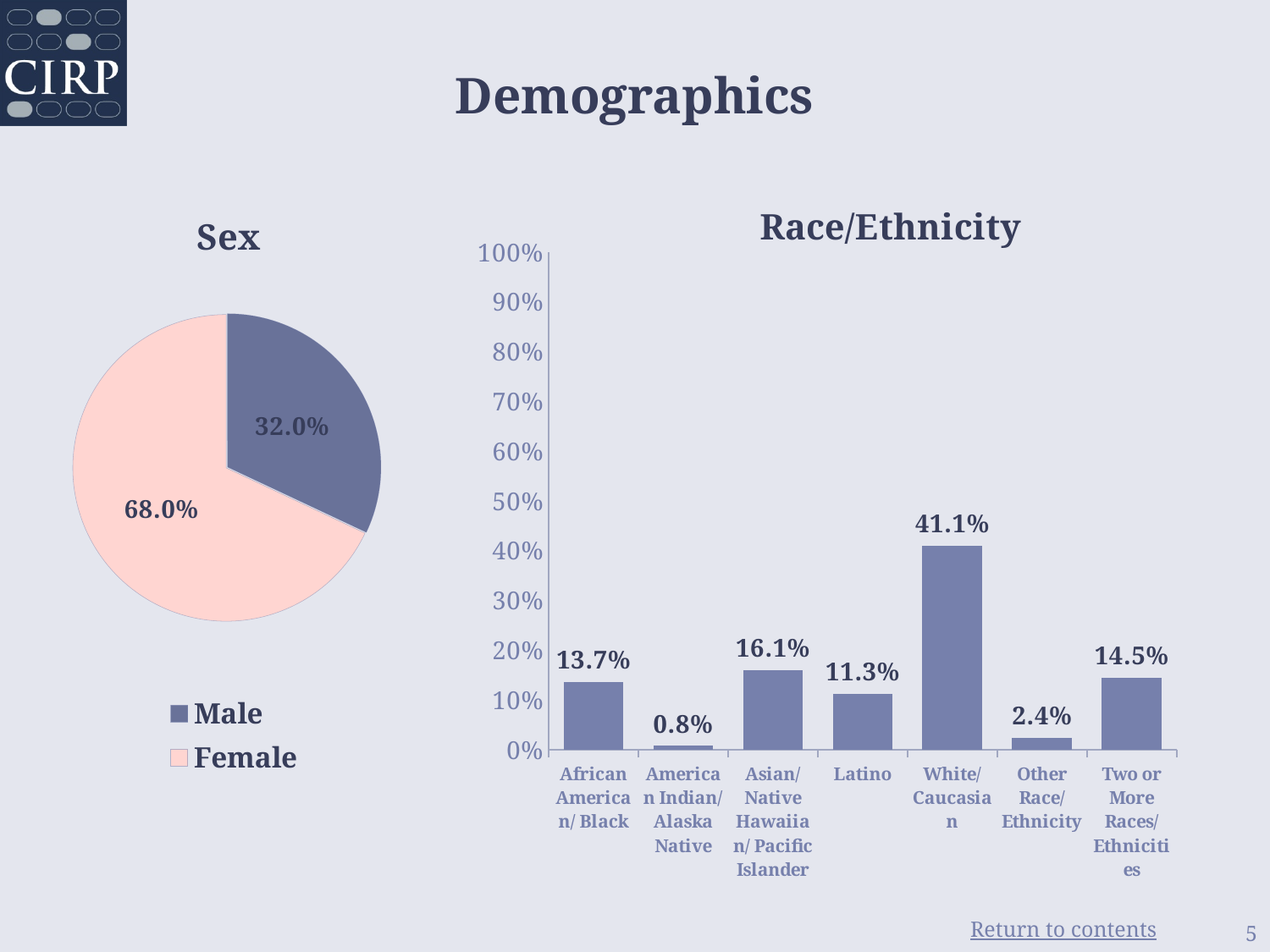
How many categories are shown in the Race/Ethnicity chart? 7 In the Sex pie chart, what is the difference between the Female and Male percentages? 36.0% In the Race/Ethnicity chart, what is the value for Latino? 11.3% In the Sex pie chart, which slice is larger, Male or Female? Female In the Race/Ethnicity chart, what is the value for White/Caucasian? 41.1% In the Race/Ethnicity chart, which category has the highest value? White/Caucasian In the Race/Ethnicity chart, which category has the lowest value? American Indian/Alaska Native In the Race/Ethnicity chart, what is the difference between Asian/Native Hawaiian/Pacific Islander and African American/Black? 2.4% In the Sex pie chart, what percentage is Female? 68.0% In the Sex pie chart, what percentage is Male? 32.0% What kind of chart is the Sex chart? Pie chart What kind of chart is the Race/Ethnicity chart? Bar chart